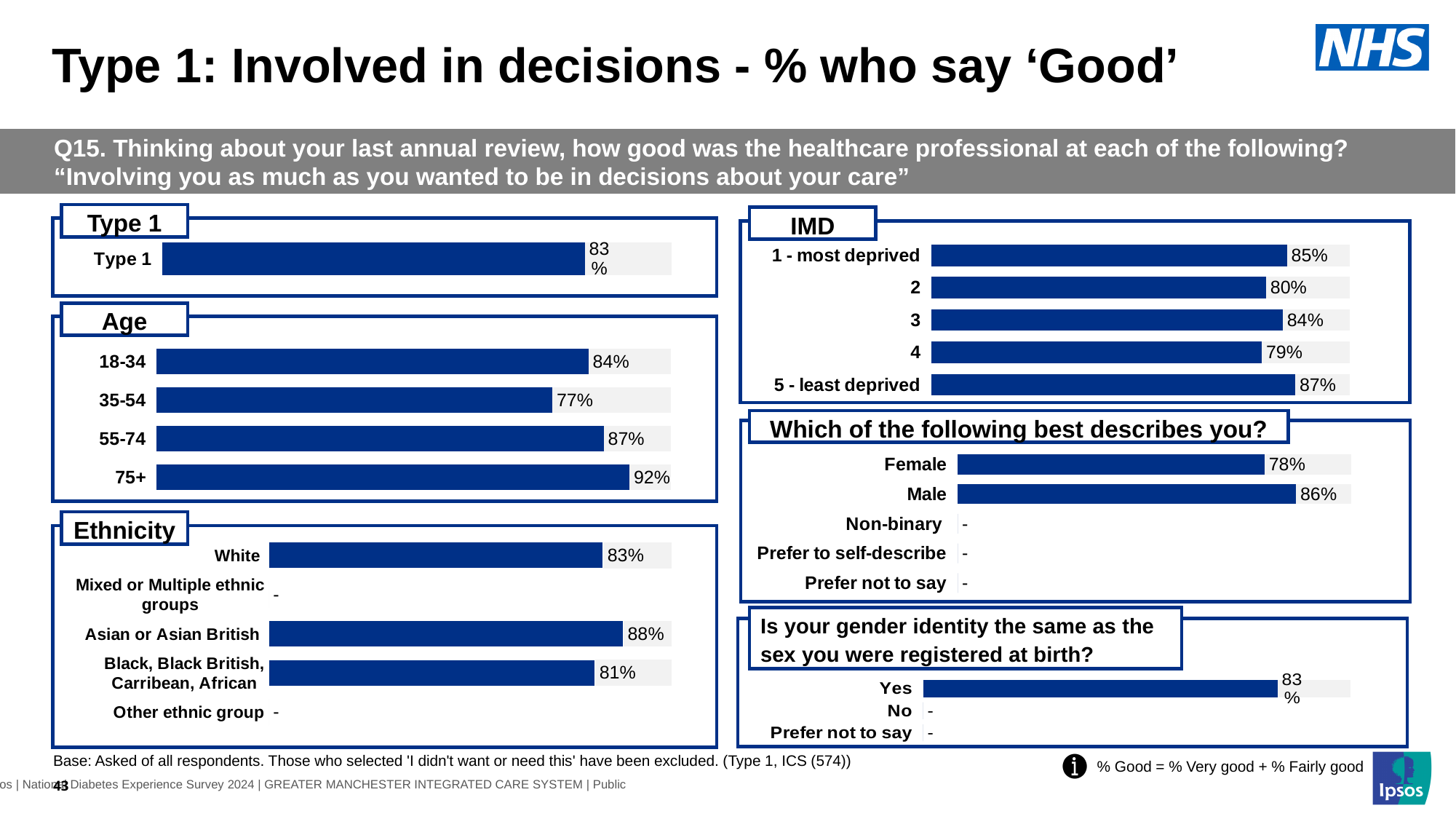
What type of chart is used in the Age section? Bar chart In the Ethnicity chart, what is the value for Asian or Asian British? 88% In the IMD chart, what is the value for '5 - least deprived'? 87% In the 'Which of the following best describes you?' chart, what is the value for Male? 86% In the Ethnicity chart, which is higher: White or Black, Black British, Carribean, African? White In the 'Is your gender identity the same as the sex you were registered at birth?' chart, what is the value for Yes? 83% In the 'Which of the following best describes you?' chart, what is the difference between Male and Female? 8 percentage points How many categories are listed in the IMD chart? 5 In the IMD chart, what is the difference between '1 - most deprived' and '2'? 5 percentage points In the IMD chart, which category has the lowest value? 4 In the Age chart, which age group has the lowest value? 35-54 In the Age chart, what is the value for the 75+ group? 92%